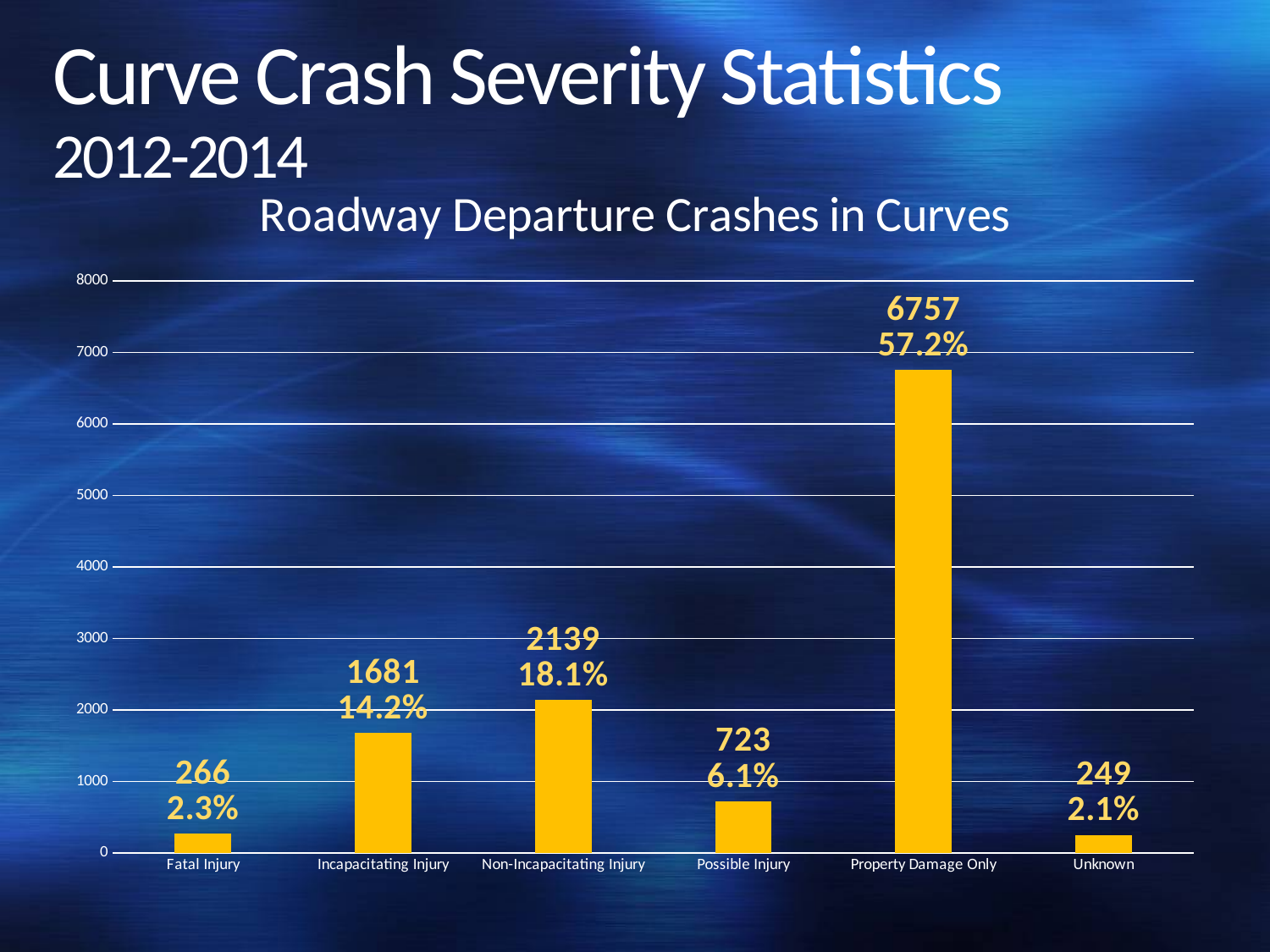
What is the number of crashes for Fatal Injury? 266 What is the difference in crashes between Non-Incapacitating Injury and Incapacitating Injury? 458 What is the number of crashes for Property Damage Only? 6757 What percentage is labelled for the Unknown category? 2.1% Which category has the lowest number of crashes? Unknown What kind of chart is shown on the slide? bar chart Which category has the highest number of crashes? Property Damage Only Is the value for Property Damage Only greater or less than 6000? greater What percentage of crashes is labelled for Non-Incapacitating Injury? 18.1% Which has more crashes, Possible Injury or Incapacitating Injury? Incapacitating Injury How many categories are shown on the x axis? 6 What is the title of the chart? Roadway Departure Crashes in Curves